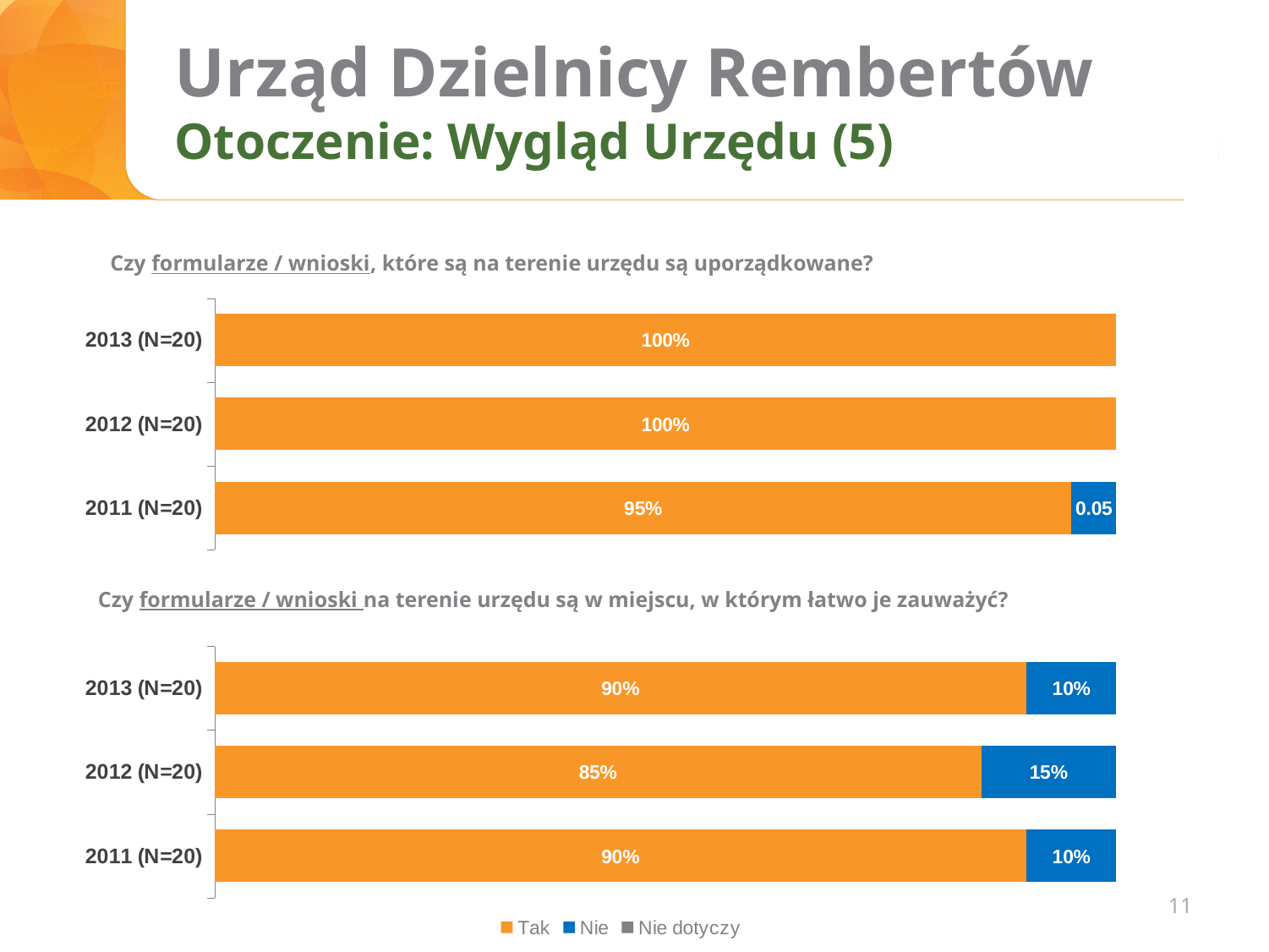
In the bottom chart, what is the difference between the 'Tak' values for 2013 (N=20) and 2012 (N=20)? 5% In the top chart, what is the 'Tak' value for 2013 (N=20)? 100% In the bottom chart, what is the 'Nie' value for 2013 (N=20)? 10% In the top chart, which is larger: the 'Tak' value for 2012 (N=20) or for 2011 (N=20)? 2012 (N=20) What type of chart is the bottom chart? Stacked bar chart In the bottom chart, which year has the lowest 'Tak' value? 2012 (N=20) In the top chart, what is the 'Tak' value for 2011 (N=20)? 95% How many year categories does the bottom chart show? 3 In the bottom chart, what is the 'Tak' value for 2012 (N=20)? 85% In the top chart, what label is shown on the 'Nie' segment for 2011 (N=20)? 0.05 How many series does the legend at the bottom of the slide list? 3 In the bottom chart, which year has the highest 'Nie' value? 2012 (N=20)